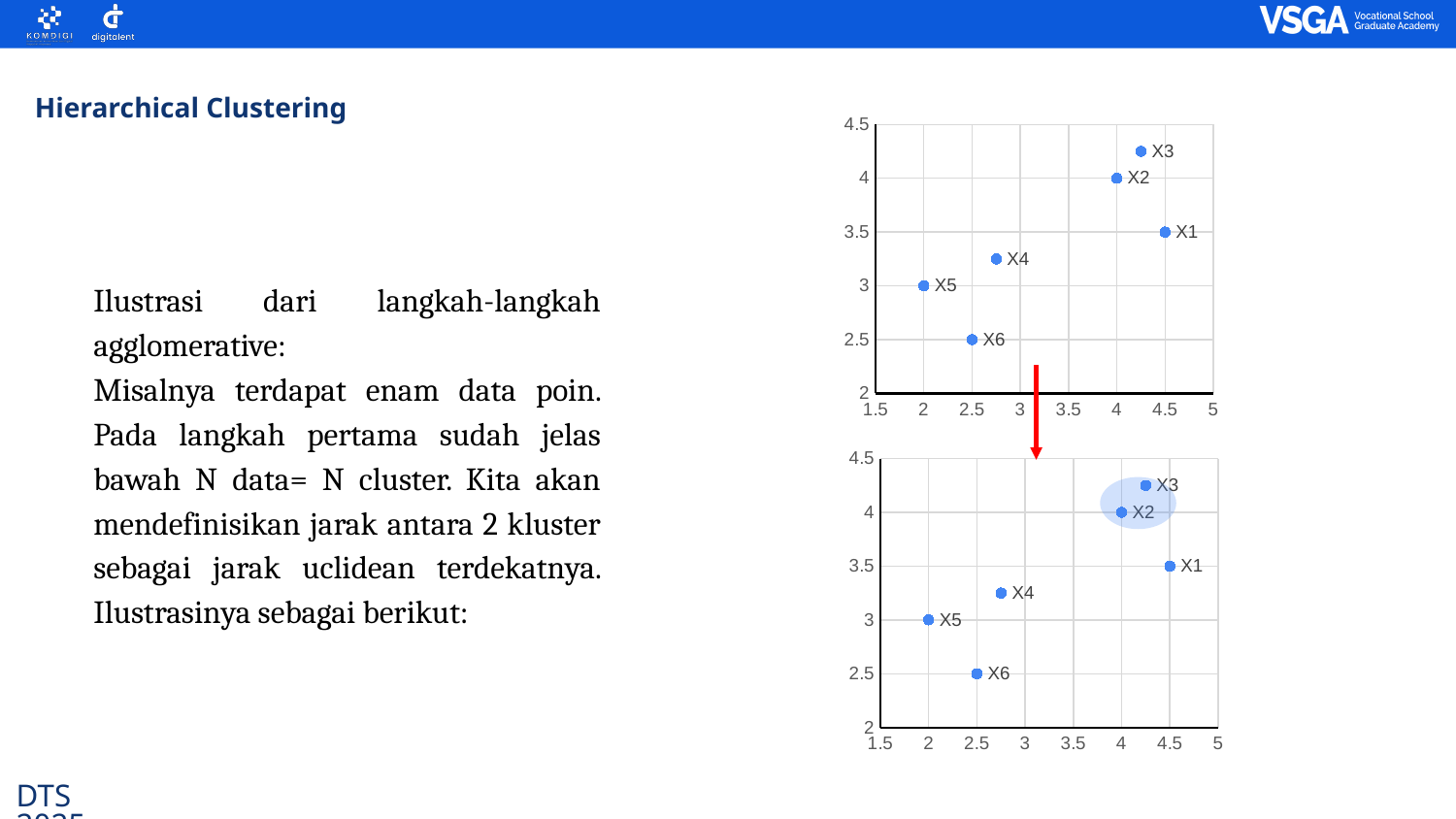
In the top chart, what is the y value of point X5? 3 In the bottom chart, is the y value of X1 greater or less than 4? less In the top chart, is the x value of X4 greater or less than 3? less How many data points are plotted in the top chart? 6 In the bottom chart, which two points are enclosed by the highlighted ellipse? X2 and X3 In the bottom chart, what is the x value of point X6? 2.5 In the top chart, which point is furthest to the right (largest x value)? X1 In the bottom chart, which point has a higher y value, X4 or X5? X4 In the top chart, which point has the highest vertical (y) value? X3 In the top chart, which point has the lowest vertical (y) value? X6 What kind of chart is the top chart on the slide? scatter chart In the top chart, which point is furthest to the left (smallest x value)? X5